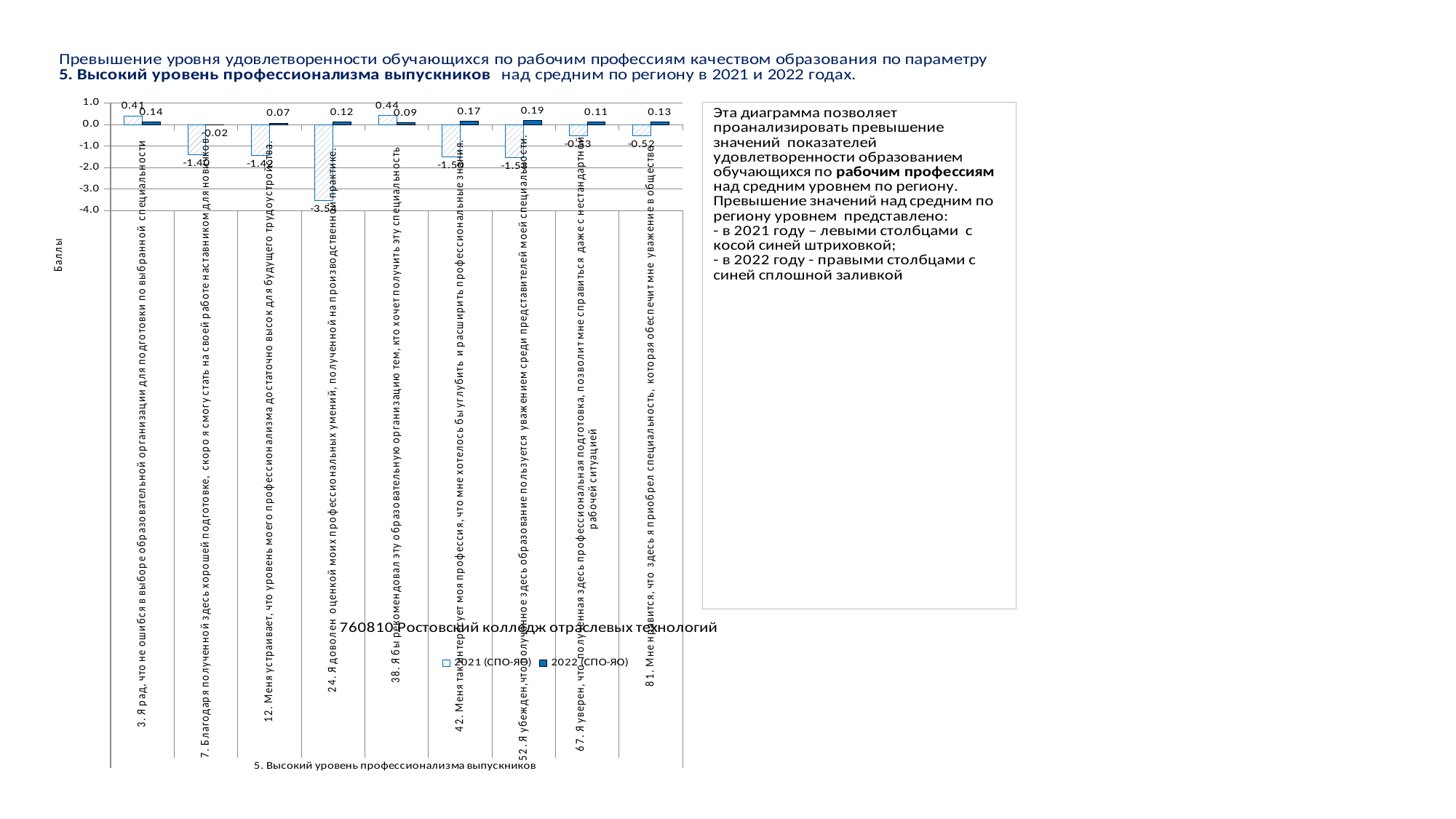
How many categories (questions) are plotted on the x axis of the chart? 9 Which category has the lowest 2022 (СПО-ЯО) value? 7. Благодаря полученной здесь хорошей подготовке, скоро я смогу стать на своей работе наставником для новичков What is the 2022 (СПО-ЯО) value for category 3 ("Я рад, что не ошибся в выборе образовательной организации...")? 0.14 What is the 2021 (СПО-ЯО) value for category 24 ("Я доволен оценкой моих профессиональных умений...")? -3.54 For category 24, which series has the larger value, 2021 (СПО-ЯО) or 2022 (СПО-ЯО)? 2022 (СПО-ЯО) What type of chart is shown on the slide? bar chart How many series does the chart legend list? 2 What is the difference between the 2021 (СПО-ЯО) and 2022 (СПО-ЯО) values for category 3? 0.27 What is the 2021 (СПО-ЯО) value for category 38 ("Я бы рекомендовал эту образовательную организацию...")? 0.44 What is the 2022 (СПО-ЯО) value for category 52 ("Я убежден, что полученное здесь образование пользуется уважением...")? 0.19 What are the two legend entries of the chart? 2021 (СПО-ЯО) and 2022 (СПО-ЯО) Which category has the lowest 2021 (СПО-ЯО) value? 24. Я доволен оценкой моих профессиональных умений, полученной на производственной практике